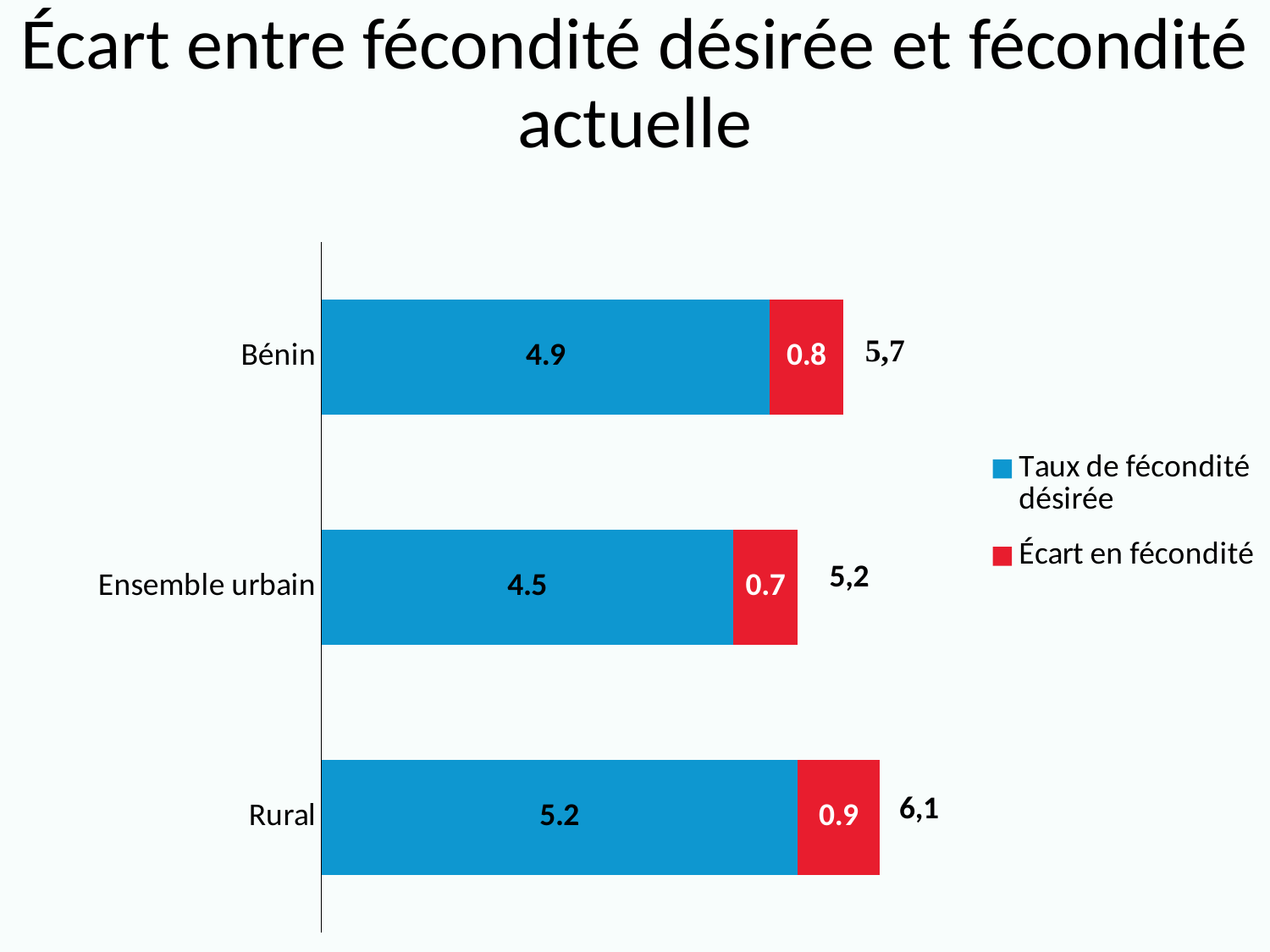
What is the total of the stacked bar for Bénin? 5,7 Which category has the highest Taux de fécondité désirée? Rural What is the total of the stacked bar for Rural? 6,1 How many categories are shown on the chart? 3 What is the value of Taux de fécondité désirée for Bénin? 4.9 Which is larger: the Écart en fécondité for Bénin or for Rural? Rural How many series does the legend list? 2 Which category has the lowest Écart en fécondité? Ensemble urbain What is the value of Écart en fécondité for Ensemble urbain? 0.7 What is the value of Taux de fécondité désirée for Ensemble urbain? 4.5 What is the difference between the Taux de fécondité désirée for Rural and for Ensemble urbain? 0.7 What is the value of Écart en fécondité for Rural? 0.9